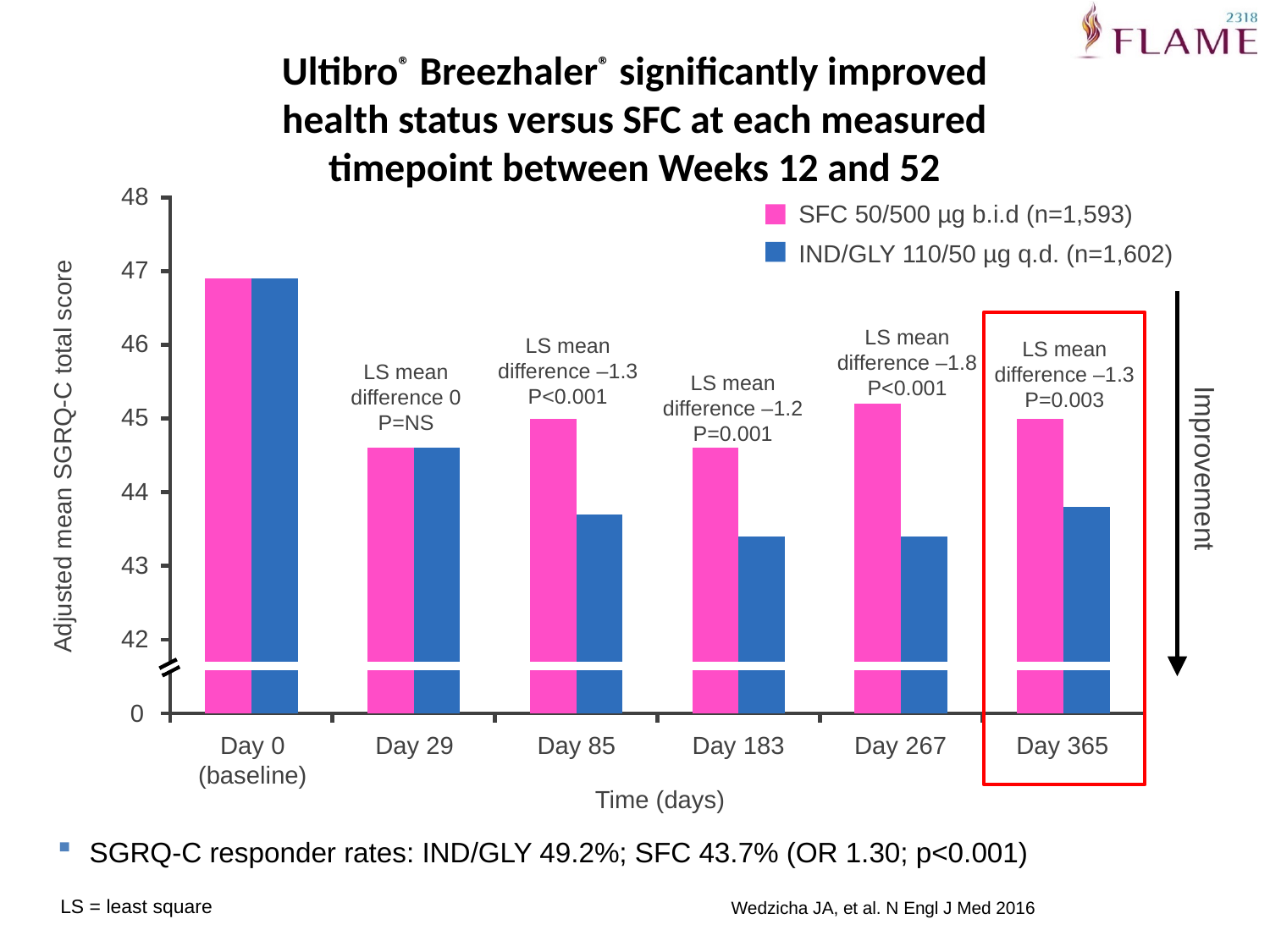
At which timepoint is the SFC bar highest? Day 0 (baseline) How many timepoints are shown on the x axis? 6 What P value is printed above the Day 365 bars? P=0.003 How many series does the legend list? 2 Is the IND/GLY value at Day 183 greater or less than 44? less Do the IND/GLY values rise or fall from Day 0 to Day 183? fall What is the LS mean difference printed above the Day 267 bars? –1.8 Which timepoint is outlined with a red box? Day 365 At Day 85, which is larger, the SFC bar or the IND/GLY bar? SFC What kind of chart is shown on the slide? bar chart Is the SFC value at Day 0 (baseline) greater or less than 46? greater What is the LS mean difference printed above the Day 29 bars? 0